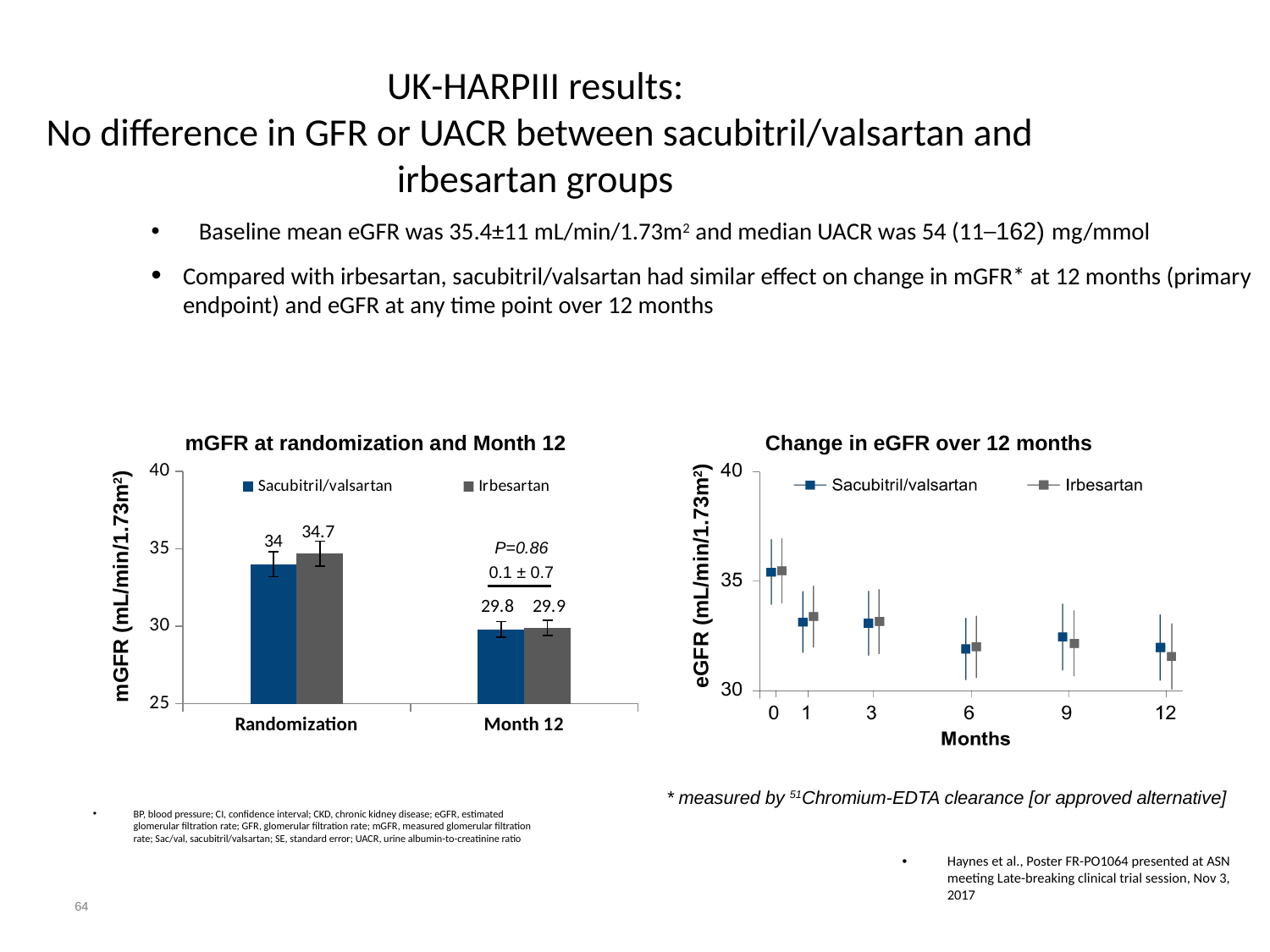
In the 'mGFR at randomization and Month 12' chart, what is the mGFR value for Irbesartan at Randomization? 34.7 In the 'mGFR at randomization and Month 12' chart, which series has the higher value at Randomization? Irbesartan In the 'Change in eGFR over 12 months' chart, how many time points are shown on the x axis? 6 In the 'mGFR at randomization and Month 12' chart, how many series does the legend list? 2 In the 'Change in eGFR over 12 months' chart, what is the label of the x axis? Months In the 'mGFR at randomization and Month 12' chart, what P value is shown for the Month 12 comparison? P=0.86 In the 'mGFR at randomization and Month 12' chart, what is the mGFR value for Irbesartan at Month 12? 29.9 In the 'mGFR at randomization and Month 12' chart, what is the difference between the Irbesartan and Sacubitril/valsartan values at Randomization? 0.7 In the 'Change in eGFR over 12 months' chart, do the eGFR values generally rise or fall from month 0 to month 12? Fall What kind of chart is 'mGFR at randomization and Month 12'? Bar chart In the 'mGFR at randomization and Month 12' chart, what is the mGFR value for Sacubitril/valsartan at Randomization? 34 In the 'Change in eGFR over 12 months' chart, is the Sacubitril/valsartan value at month 0 greater or less than 35? greater